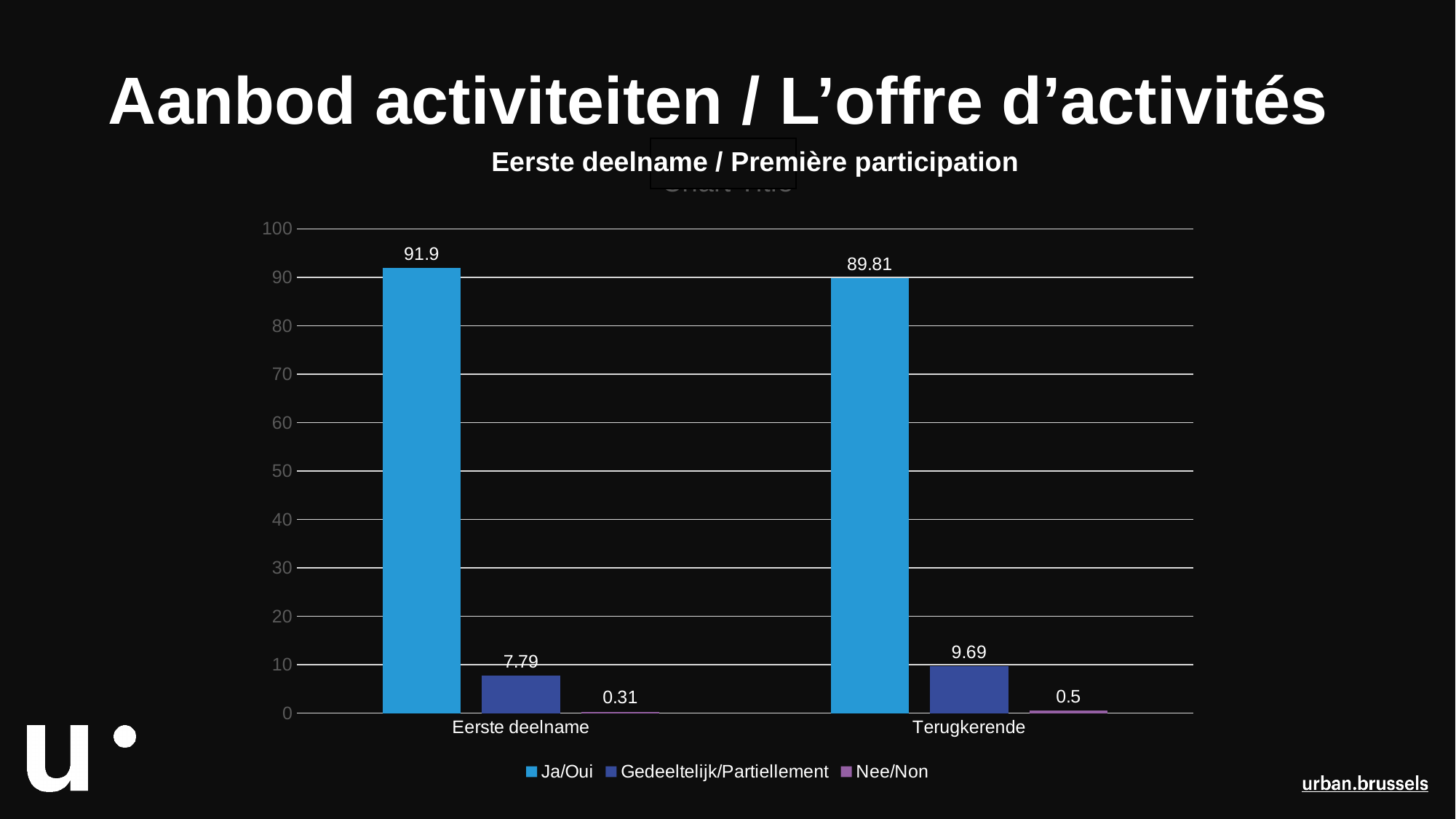
What is the value for Nee/Non in the Eerste deelname category? 0.31 What is the value for Ja/Oui in the Terugkerende category? 89.81 What kind of chart is shown on the slide? Bar chart What is the difference between the Ja/Oui values for Eerste deelname and Terugkerende? 2.09 What is the title of the chart? Eerste deelname / Première participation Which series has the lowest value in the Eerste deelname category? Nee/Non How many categories are shown on the x axis? 2 What is the value for Ja/Oui in the Eerste deelname category? 91.9 Which series has the highest value in the Terugkerende category? Ja/Oui How many series does the legend list? 3 What is the value for Gedeeltelijk/Partiellement in the Terugkerende category? 9.69 Which is larger: the Gedeeltelijk/Partiellement value for Eerste deelname or for Terugkerende? Terugkerende